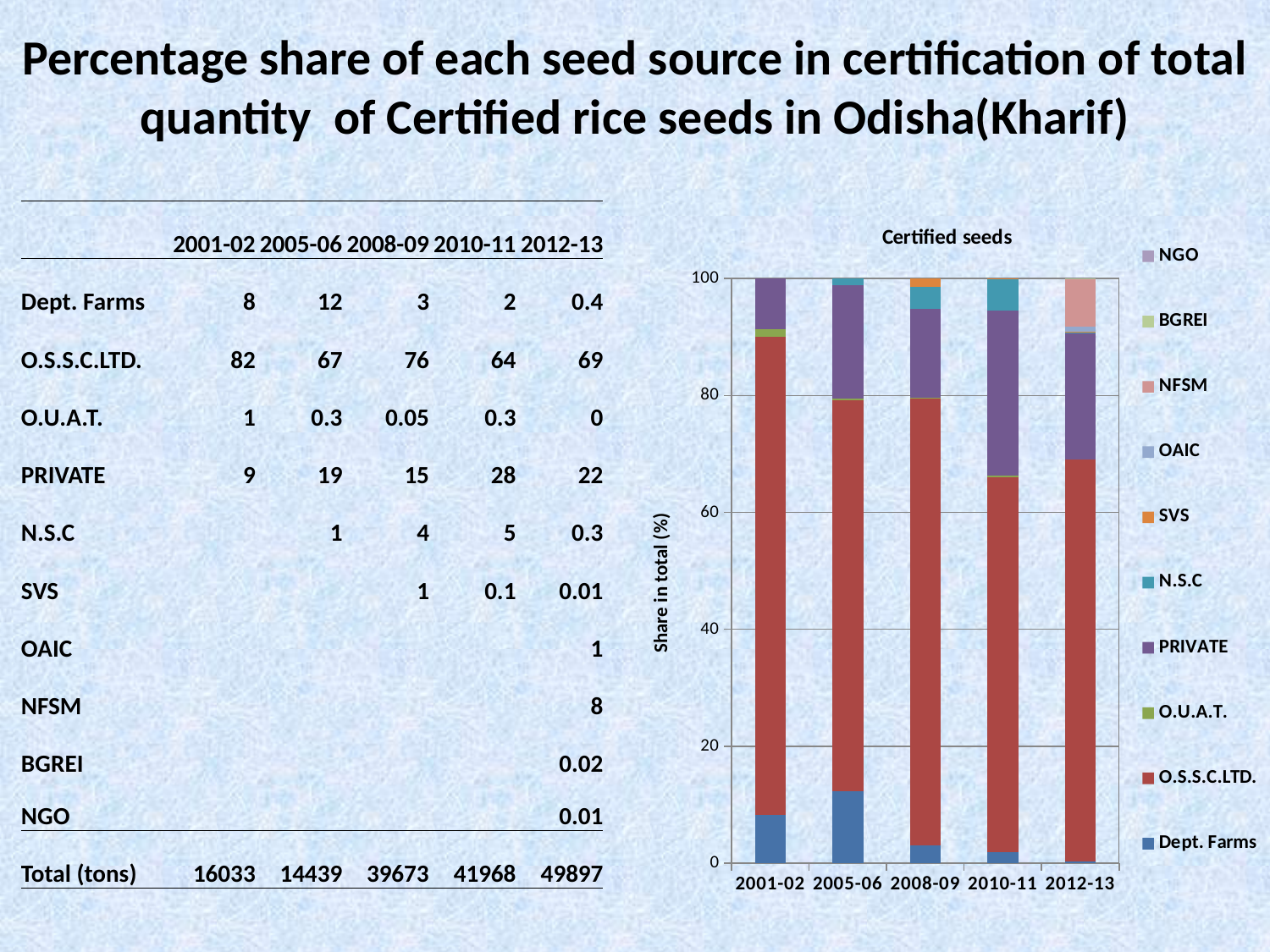
What is the difference between the PRIVATE share in 2010-11 and in 2001-02? 19 How many series does the chart legend list? 10 Which is larger, the Dept. Farms share in 2001-02 or in 2008-09? 2001-02 What is the percentage share of O.S.S.C.LTD. in 2001-02? 82 In which year is the Dept. Farms share the highest? 2005-06 What kind of chart is shown on the slide? Stacked bar chart Does the Dept. Farms share rise or fall from 2005-06 to 2012-13? fall In which year is the O.S.S.C.LTD. share the highest? 2001-02 How many years (categories) are plotted on the x axis of the chart? 5 What is the title of the chart's vertical axis? Share in total (%) Is the Dept. Farms value for 2005-06 greater or less than 20? less What is the percentage share of PRIVATE in 2010-11? 28